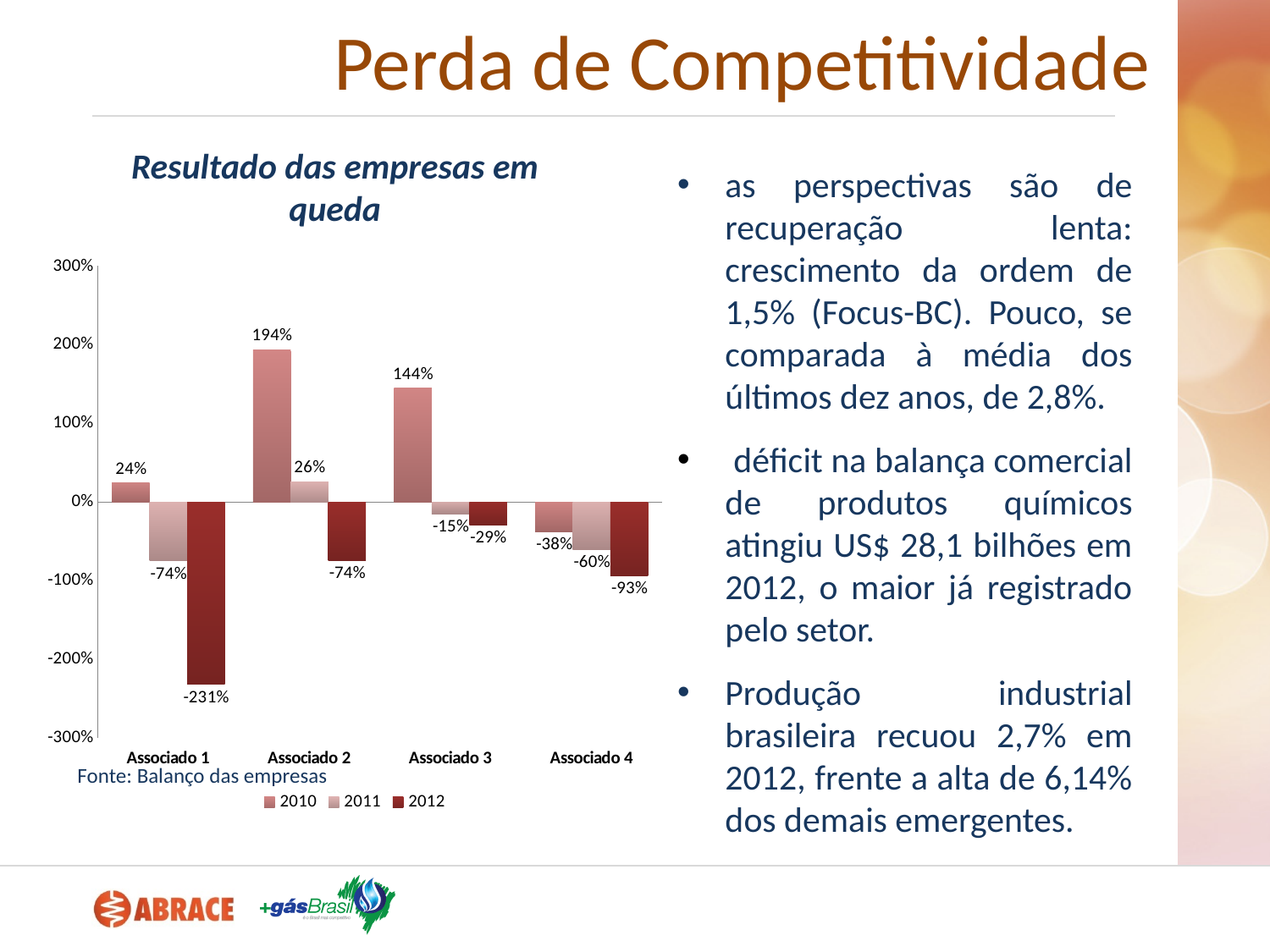
What is the difference between the 2010 values for Associado 2 and Associado 3? 50% What is the value for Associado 2 in 2010? 194% Which category has the lowest value in the 2012 series? Associado 1 What is the value for Associado 3 in 2011? -15% Which category has the highest value in the 2010 series? Associado 2 How many series does the legend list? 3 What is the value for Associado 1 in 2012? -231% How many categories are shown on the x axis? 4 What kind of chart is shown on the slide? Bar chart Which is larger, the 2011 value for Associado 2 or the 2011 value for Associado 4? Associado 2 What is the title of the chart? Resultado das empresas em queda What is the value for Associado 4 in 2012? -93%